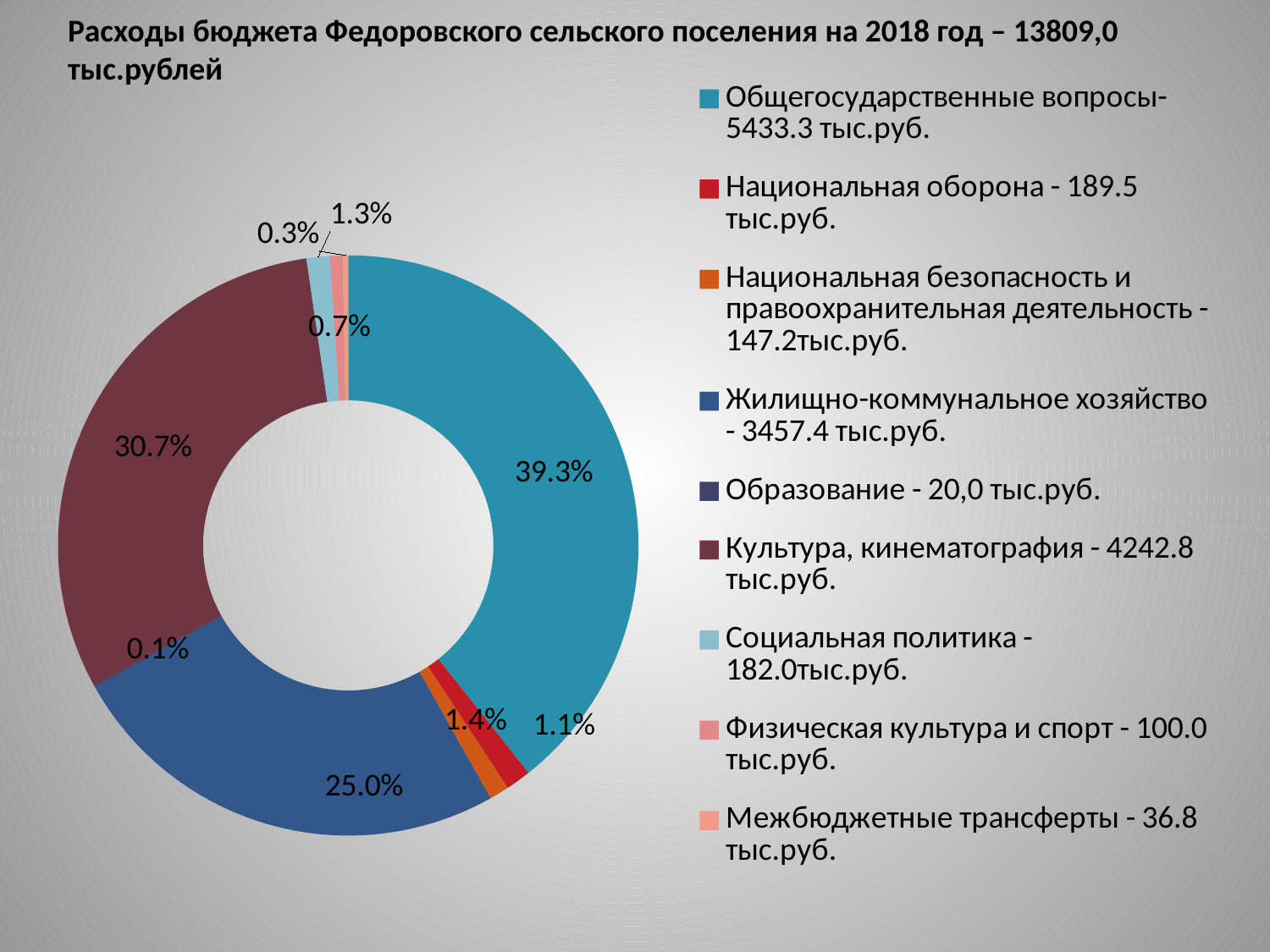
Which category has the largest share of expenditures? Общегосударственные вопросы Which category has the smallest share of expenditures? Образование How many categories does the legend list? 9 What type of chart is shown on the slide? Doughnut (pie) chart What is the difference in percentage points between the share for Общегосударственные вопросы and the share for Культура, кинематография? 8.6% What share of the budget expenditures goes to Общегосударственные вопросы? 39.3% What share of the budget expenditures goes to Жилищно-коммунальное хозяйство? 25.0% What share of the budget expenditures goes to Культура, кинематография? 30.7% What amount in тыс.руб. is allocated to Социальная политика according to the legend? 182.0 тыс.руб. What amount in тыс.руб. is allocated to Национальная оборона according to the legend? 189.5 тыс.руб. What total budget expenditure amount is stated in the chart title? 13809,0 тыс.рублей Which is larger: the share for Культура, кинематография or the share for Жилищно-коммунальное хозяйство? Культура, кинематография